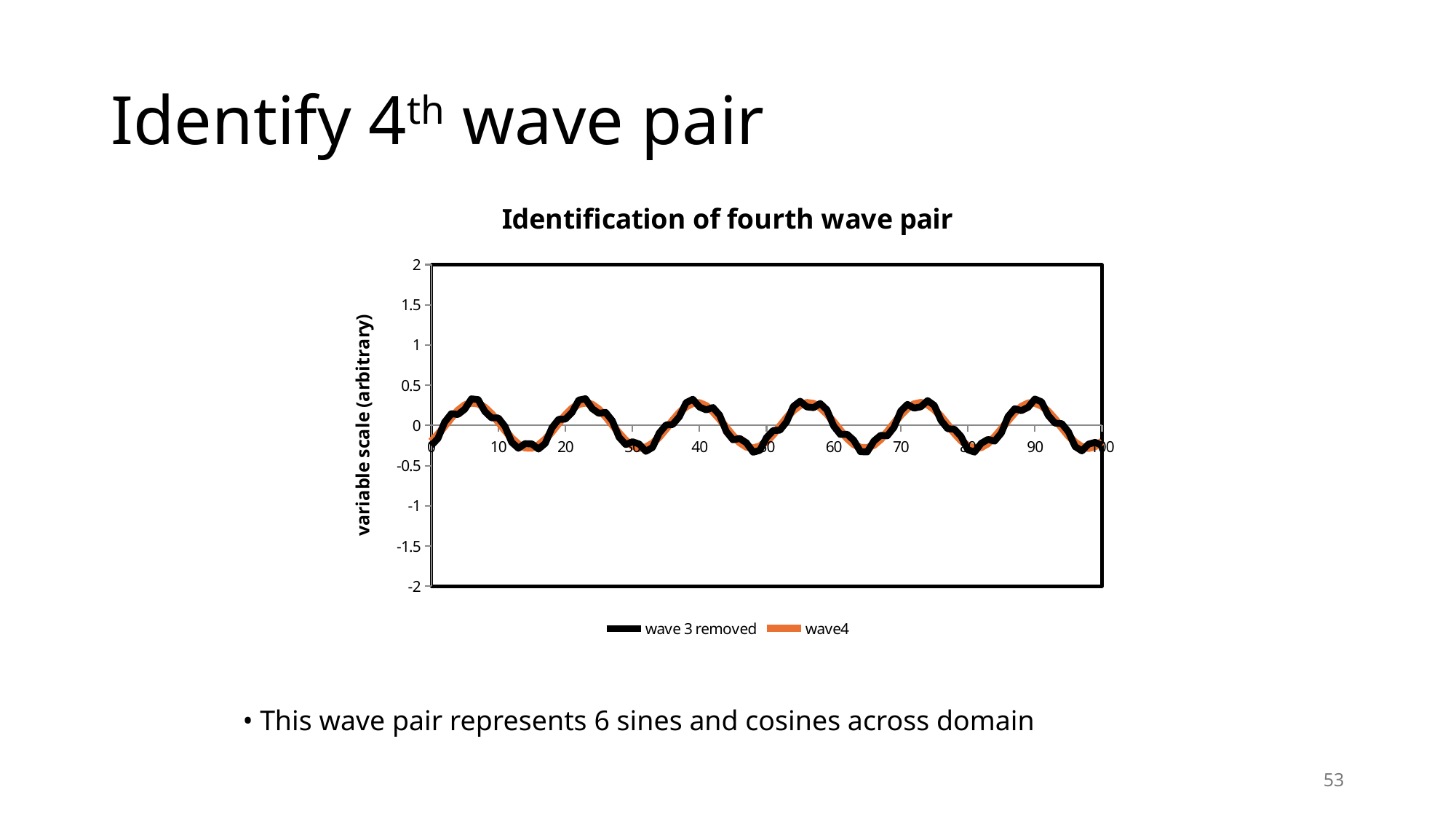
Is the lowest value reached by the wave4 series greater or less than -0.5? greater How many series does the legend list? 2 What kind of chart is shown on the slide? line chart What is the maximum value shown on the vertical axis? 2 Is the highest value reached by the 'wave 3 removed' series greater or less than 1? less What is the label on the vertical axis of the chart? variable scale (arbitrary) Is the lowest value reached by the 'wave 3 removed' series greater or less than -1? greater Which series is drawn in orange? wave4 How many peaks (crests) does the wave4 series show across the x-axis range from 0 to 100? 6